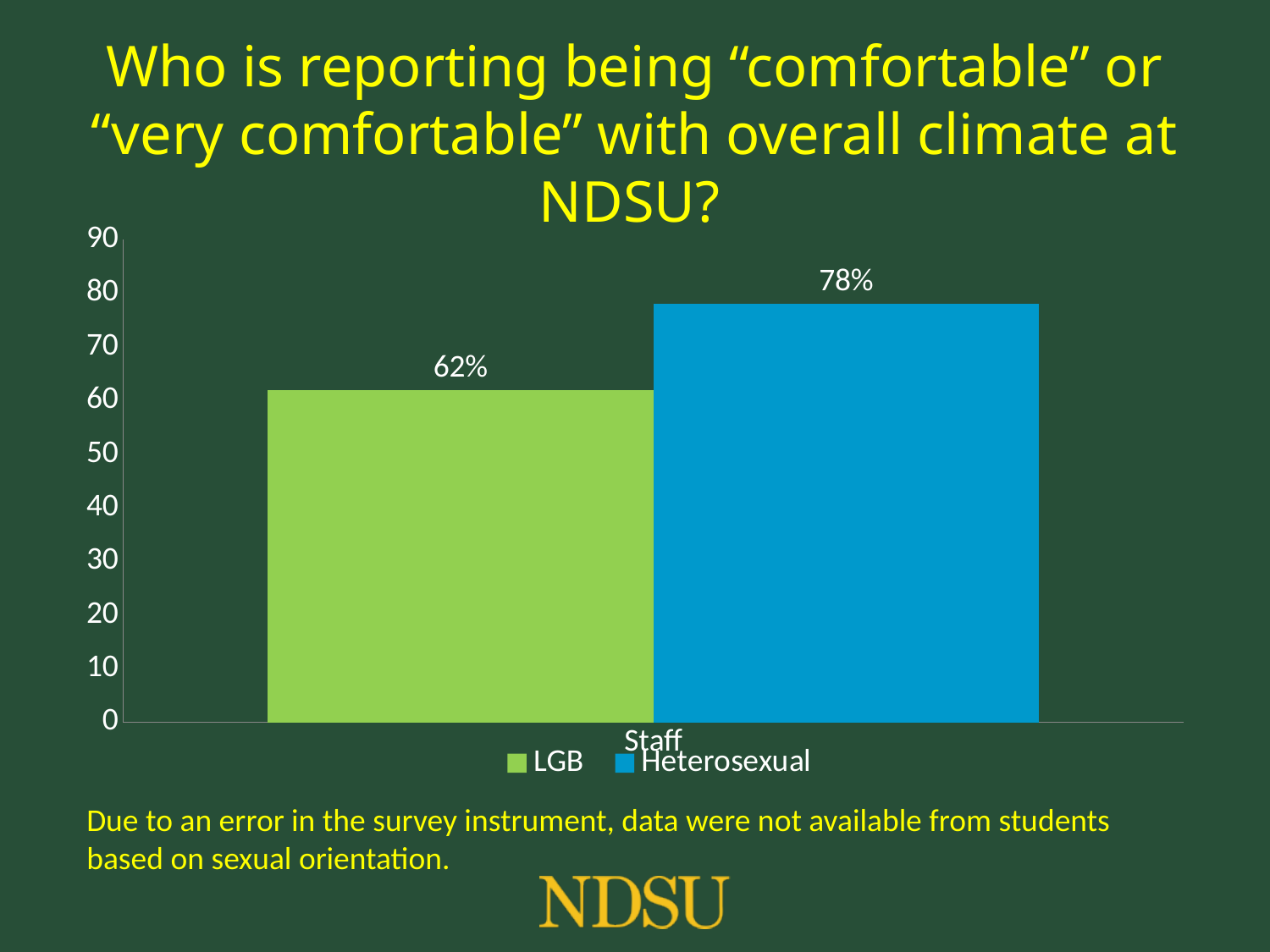
Which series has the higher value for Staff, LGB or Heterosexual? Heterosexual What percentage of Heterosexual staff report being comfortable or very comfortable with the overall climate at NDSU? 78% What is the category label on the x axis? Staff Is the value for Heterosexual staff greater or less than 70? greater Which series has the lower value for Staff? LGB How many series does the legend list? 2 What colour is the bar for the Heterosexual series? Blue What kind of chart is shown on the slide? Bar chart Is the value for LGB staff greater or less than 70? less How many categories are shown on the x axis? 1 What percentage of LGB staff report being comfortable or very comfortable with the overall climate at NDSU? 62% What is the difference in percentage points between the Heterosexual and LGB values for Staff? 16